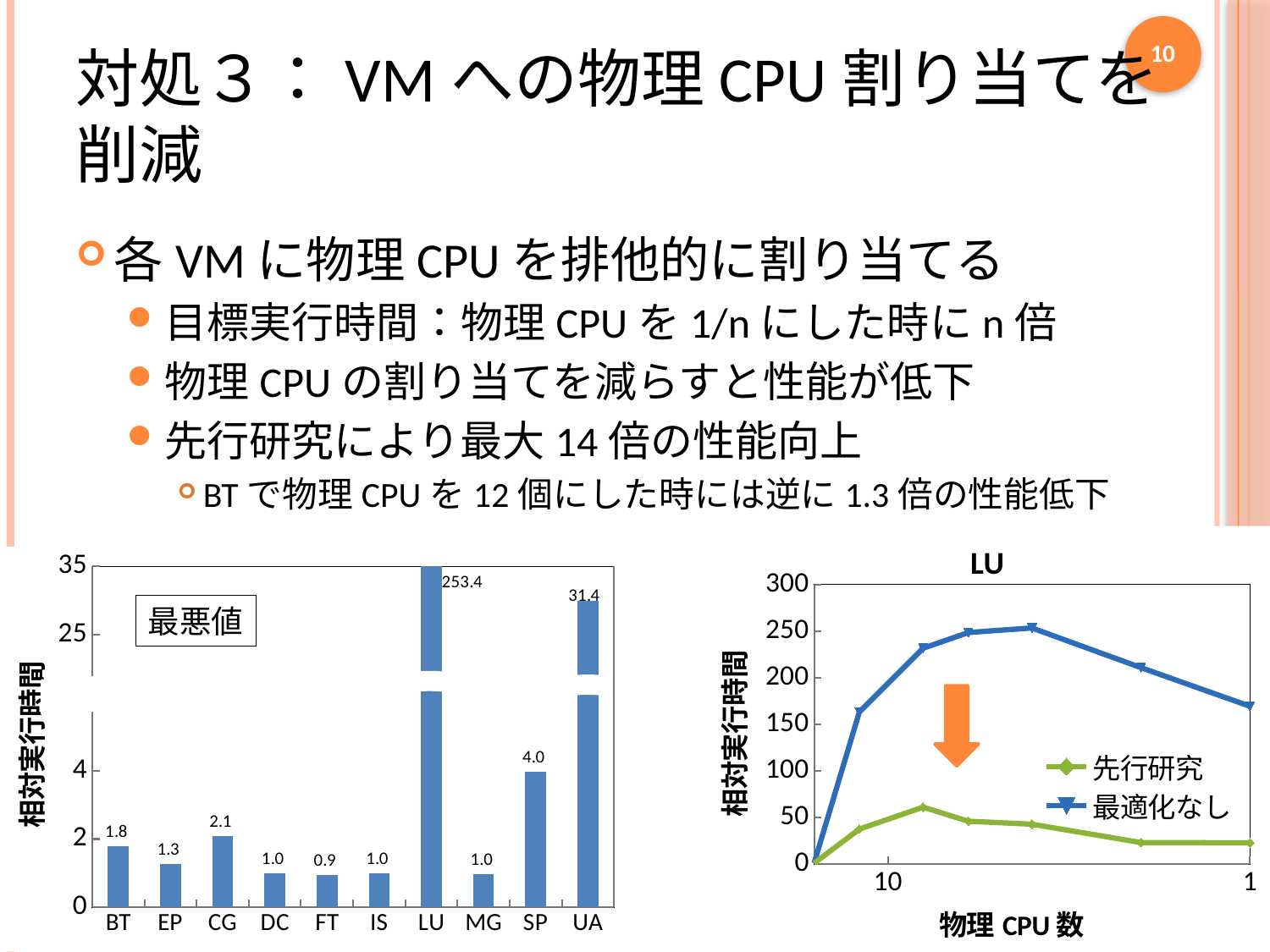
In the chart titled LU, how many series does the legend list? 2 In the chart titled LU, what is the label of the x axis? 物理 CPU 数 In the left bar chart, what is the value for LU? 253.4 What kind of chart is the chart on the left of the slide? bar chart In the left bar chart, what is the value for SP? 4.0 In the left bar chart, which category has the highest value? LU In the left bar chart, which category has the lowest value? FT In the left bar chart, what is the difference between the values for UA and SP? 27.4 In the chart titled LU, is the highest value of the 最適化なし series greater or less than 200? greater In the left bar chart, which is larger, the value for CG or the value for EP? CG How many categories are shown on the x axis of the left bar chart? 10 In the left bar chart, what is the value for BT? 1.8